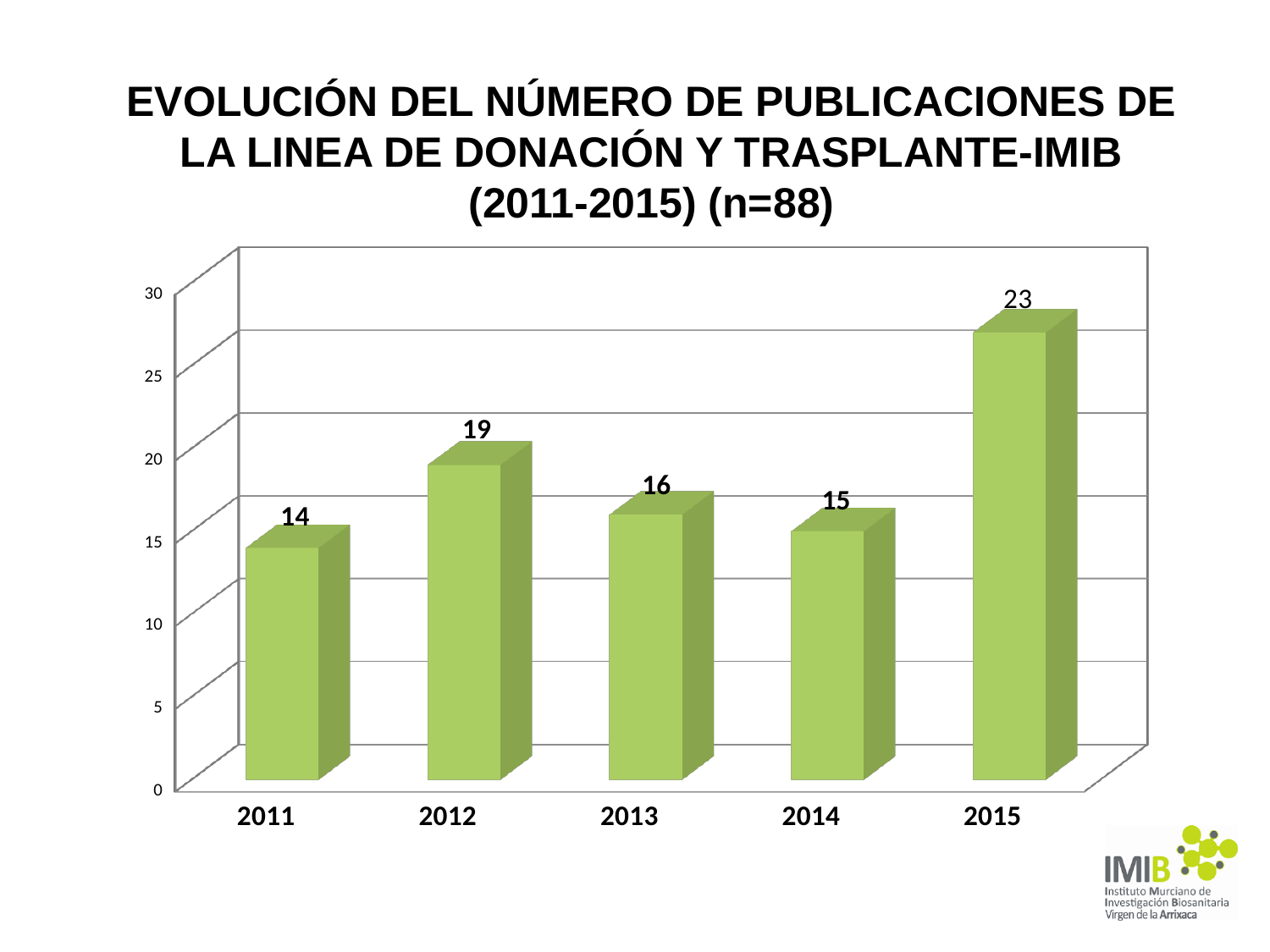
What is the number of publications in 2014? 15 What kind of chart is shown on the slide? Bar chart What is the number of publications in 2012? 19 What is the difference between the number of publications in 2015 and in 2011? 9 How many years are shown on the x axis? 5 What is the difference between the number of publications in 2012 and in 2013? 3 What is the total number of publications across all five years shown? 87 Which year has more publications, 2013 or 2014? 2013 Which year has the lowest number of publications? 2011 Is the value for 2015 greater or less than 20? greater Which year has the highest number of publications? 2015 What is the number of publications in 2011? 14